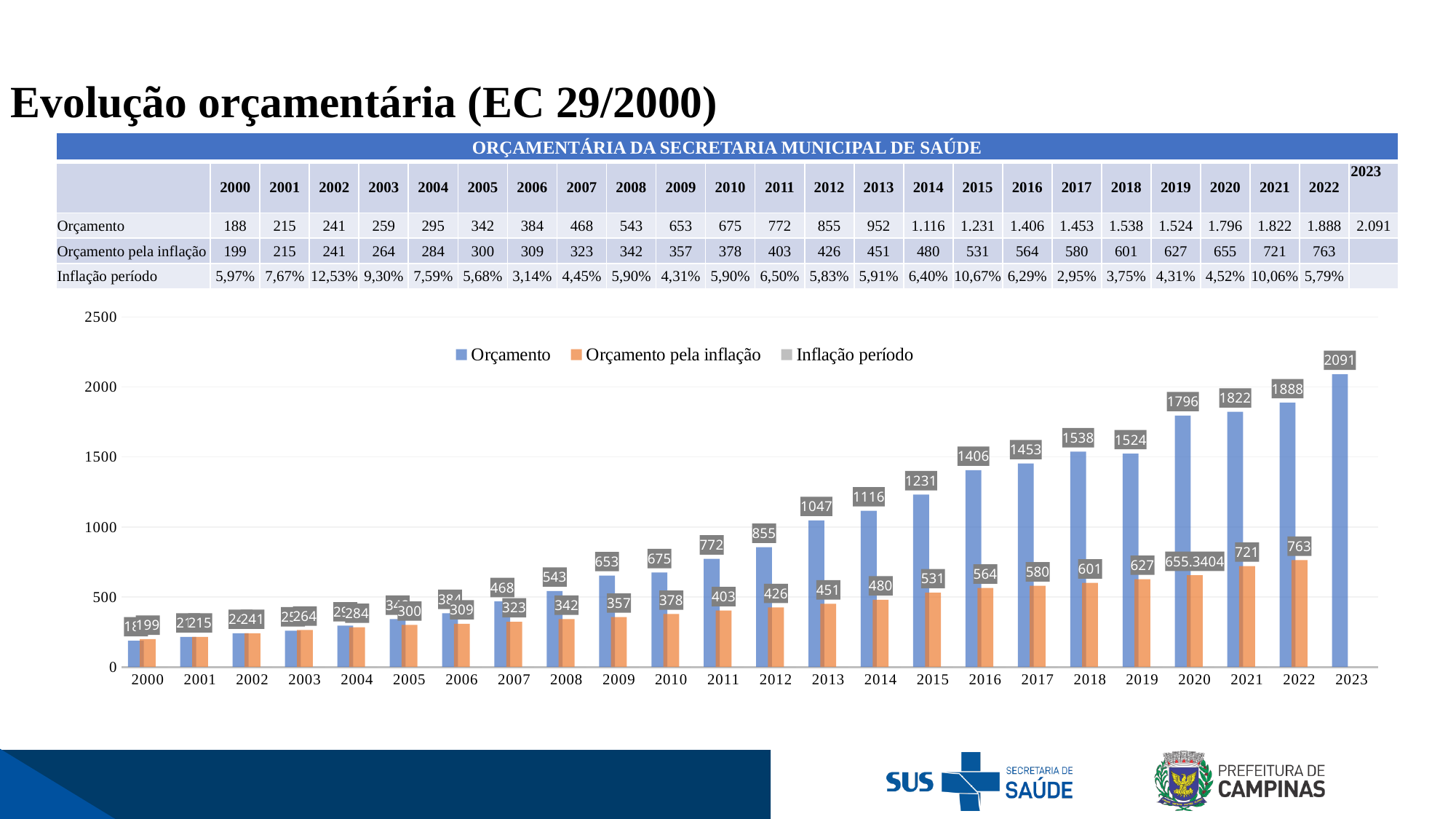
What is the Orçamento value for 2010 in the chart? 675 In the chart, what is the difference between the Orçamento values for 2021 and 2020? 26 In the chart, what is the difference between the Orçamento and the Orçamento pela inflação values for 2022? 1125 How many series does the chart legend list? 3 Which year has the highest Orçamento value in the chart? 2023 Is the Orçamento value for 2019 in the chart greater or less than 1500? greater Which year has the lowest Orçamento value in the chart? 2000 What is the Orçamento value for 2023 in the chart? 2091 What kind of chart is shown on the slide? bar chart How many years are shown on the x axis of the chart? 24 What is the Orçamento pela inflação value for 2022 in the chart? 763 In the chart, which is larger: the Orçamento value for 2015 or the Orçamento pela inflação value for 2016? Orçamento for 2015